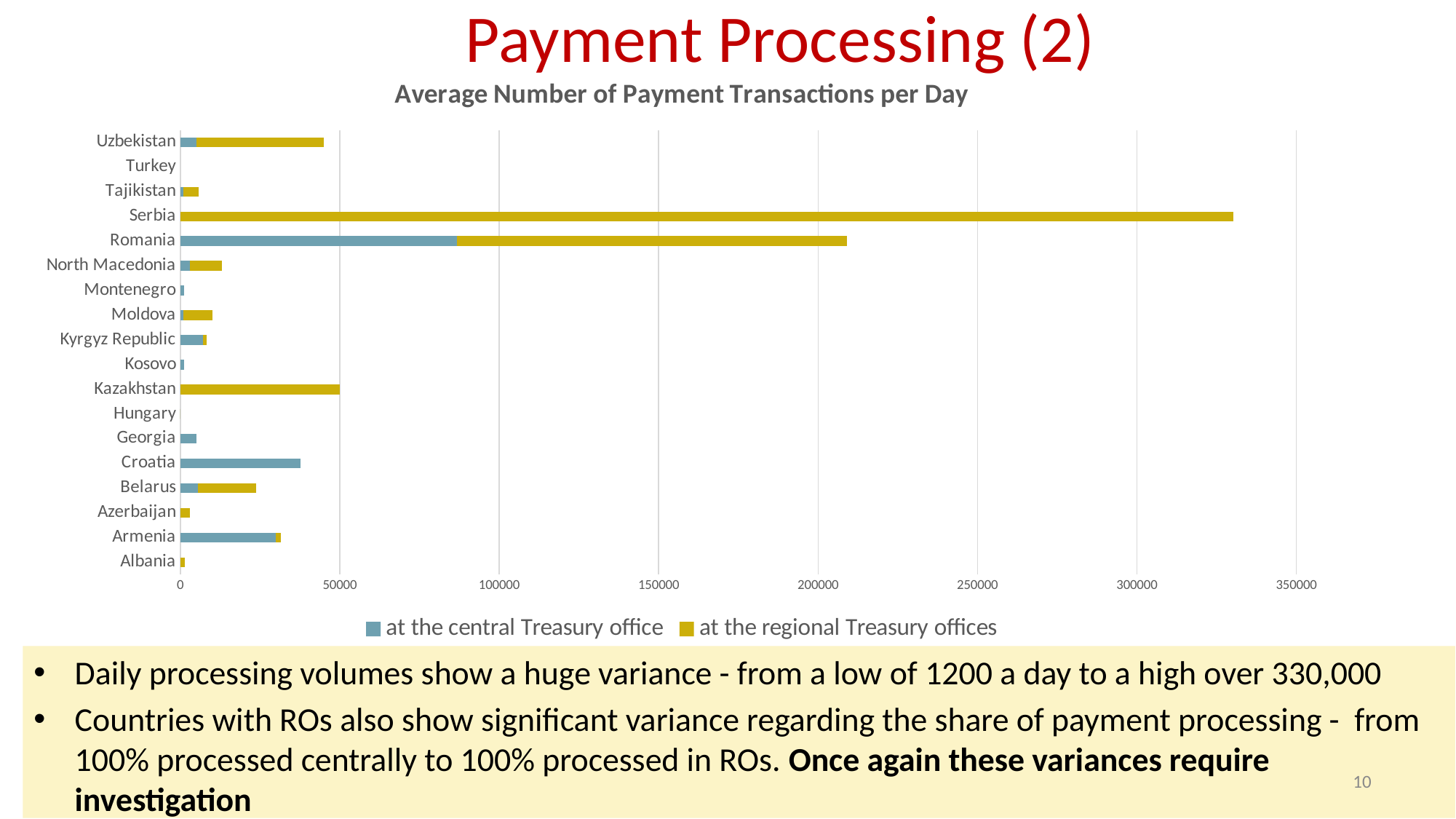
What kind of chart is shown on the slide? bar chart Is the total value for Romania greater or less than 200000? greater How many countries are listed on the vertical axis of the chart? 18 Is the total value for Serbia greater or less than 300000? greater Is the total value for Uzbekistan greater or less than 50000? less How many series does the legend list? 2 What is the title of the chart? Average Number of Payment Transactions per Day Which country has the highest total average number of payment transactions per day? Serbia Which has a larger total value, Croatia or Armenia? Croatia Which country has the longest bar for transactions processed at the central Treasury office? Romania Which has a larger total value, Serbia or Romania? Serbia